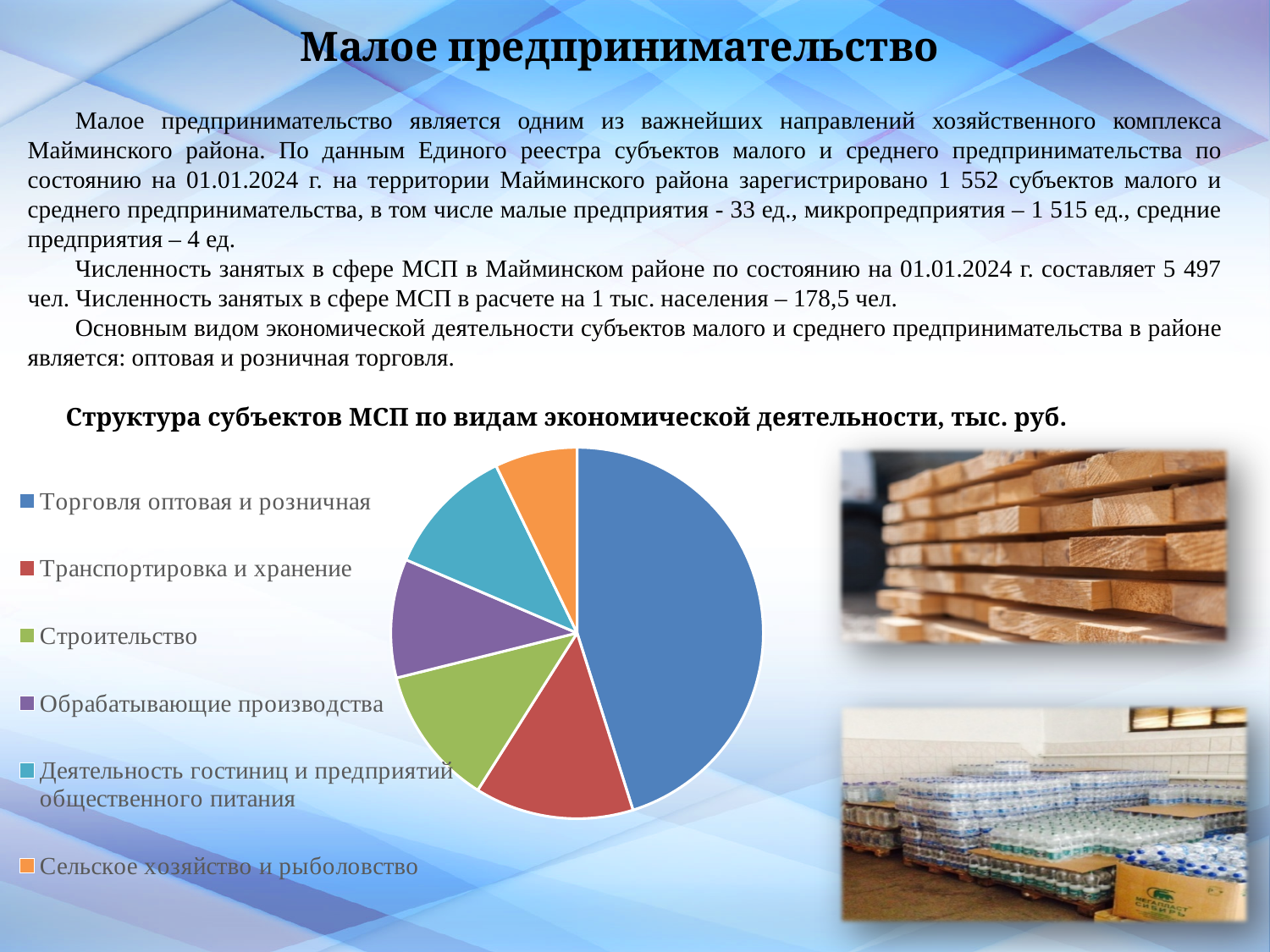
Which slice is larger: Транспортировка и хранение or Сельское хозяйство и рыболовство? Транспортировка и хранение What kind of chart is shown on the slide? pie chart What is the title of the pie chart? Структура субъектов МСП по видам экономической деятельности, тыс. руб. How many categories (slices) does the pie chart have? 6 Which category has the largest slice in the pie chart? Торговля оптовая и розничная Which slice is larger: Строительство or Сельское хозяйство и рыболовство? Строительство Which slice is larger: Торговля оптовая и розничная or Транспортировка и хранение? Торговля оптовая и розничная Which category has the smallest slice in the pie chart? Сельское хозяйство и рыболовство How many entries does the legend of the pie chart list? 6 What colour is the slice for Деятельность гостиниц и предприятий общественного питания? teal (light blue)